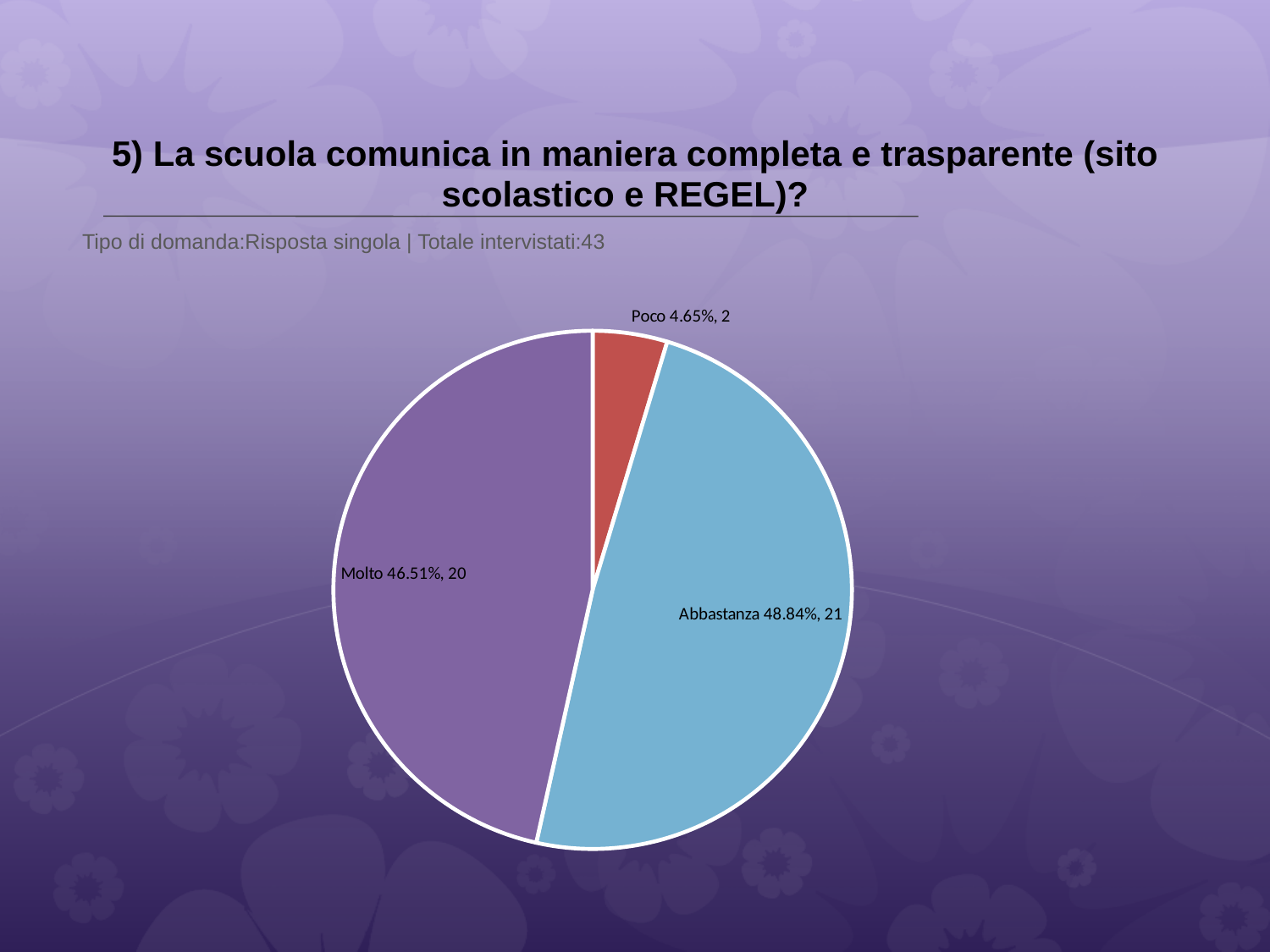
Which response has the largest slice of the pie? Abbastanza What is the difference in respondent count between Abbastanza and Molto? 1 How many slices does the pie chart have? 3 What kind of chart is shown on the slide? pie chart How many respondents answered Abbastanza? 21 What colour is the Poco slice? red What percentage share does the Abbastanza slice have? 48.84% What percentage share does the Poco slice have? 4.65% How many respondents answered Poco? 2 What percentage share does the Molto slice have? 46.51% How many respondents answered Molto? 20 Which response has the smallest slice of the pie? Poco